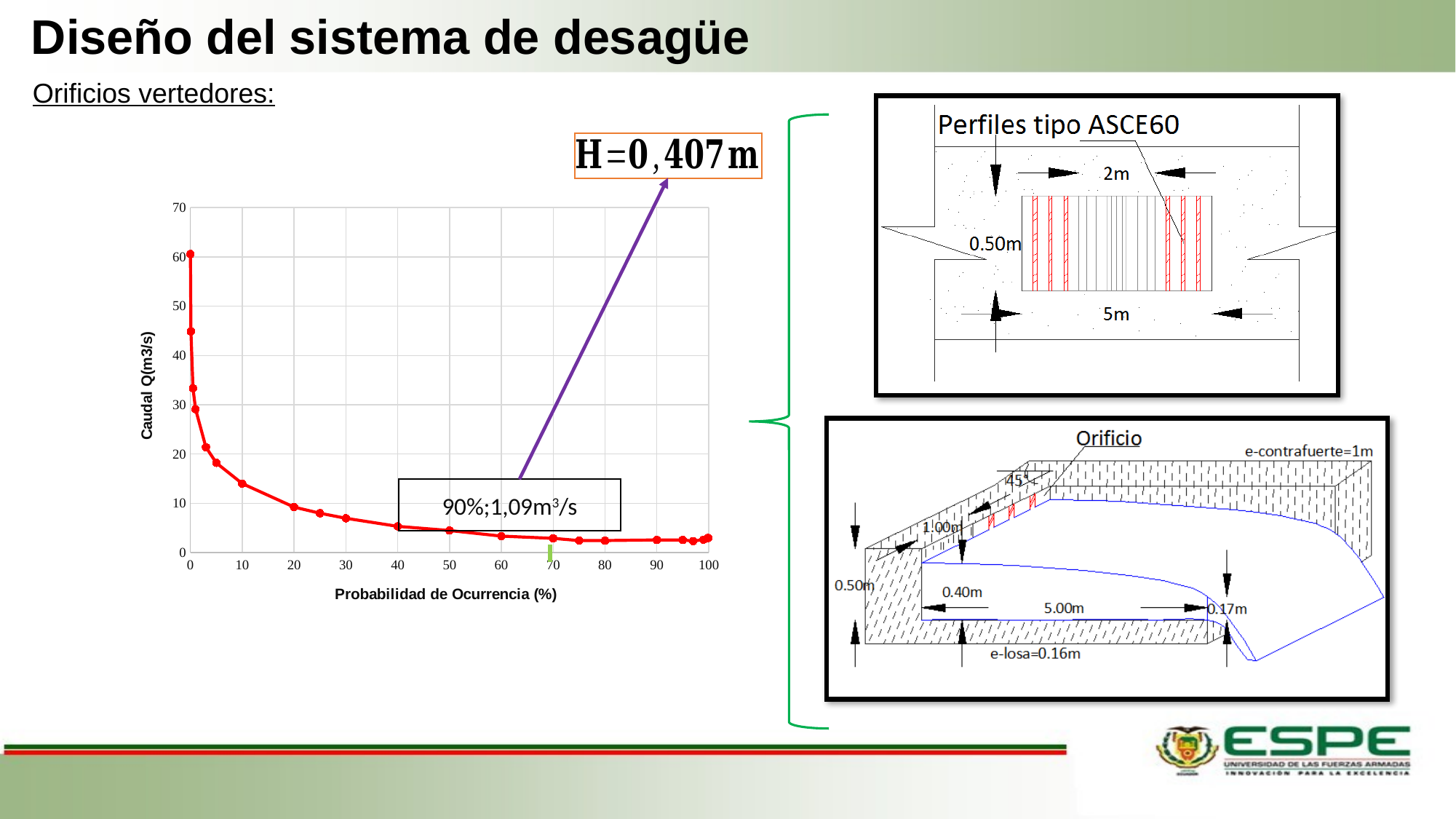
Is the flow value at a 50% probability of occurrence greater or less than 10 m3/s? less What is the title of the x axis of the chart? Probabilidad de Ocurrencia (%) Is the flow value at a 70% probability of occurrence greater or less than 10 m3/s? less Is the flow value at a 30% probability of occurrence greater or less than 10 m3/s? less At which probability of occurrence is the flow (caudal) highest? 0% According to the annotation on the chart, what is the flow (caudal) at a 90% probability of occurrence? 1,09m³/s What is the title of the y axis of the chart? Caudal Q(m3/s) What kind of chart is shown on the slide? Line chart Do the values rise or fall as the probability of occurrence increases along the x axis? Fall Which has a larger flow value: a 10% probability of occurrence or a 40% probability of occurrence? 10%